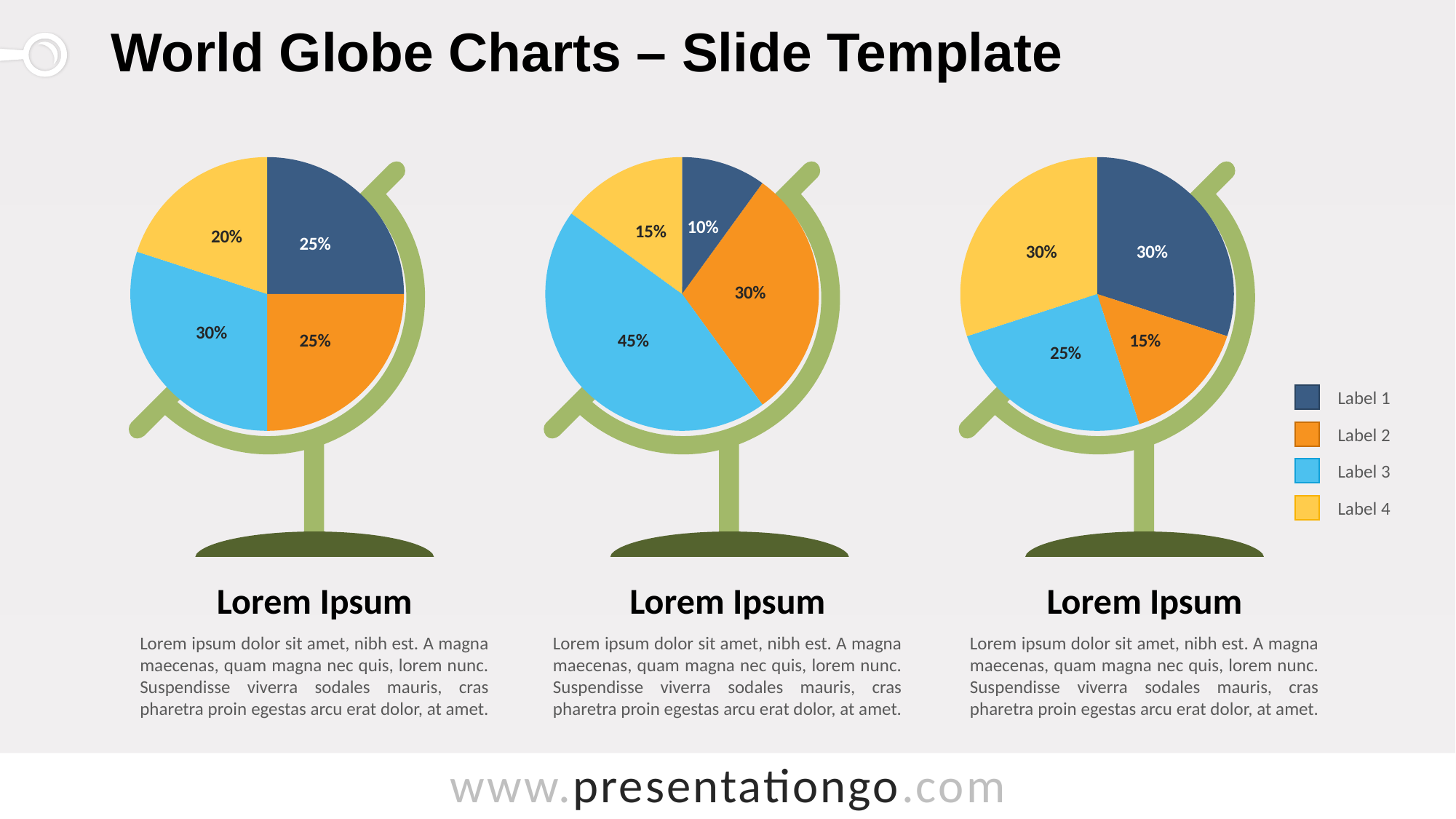
In the right pie chart, which is larger, Label 3 or Label 2? Label 3 In the right pie chart, what is the value for Label 2? 15% In the left pie chart, what is the value for Label 3? 30% How many entries does the legend list? 4 In the middle pie chart, what is the difference between the values for Label 3 and Label 2? 15% What kind of chart is shown in the middle globe? Pie chart In the right pie chart, which label has the smallest share? Label 2 In the middle pie chart, which label has the largest share? Label 3 How many slices does the left pie chart have? 4 What colour represents Label 4 in the legend? Yellow In the middle pie chart, what is the value for Label 1? 10% In the left pie chart, which label has the smallest share? Label 4